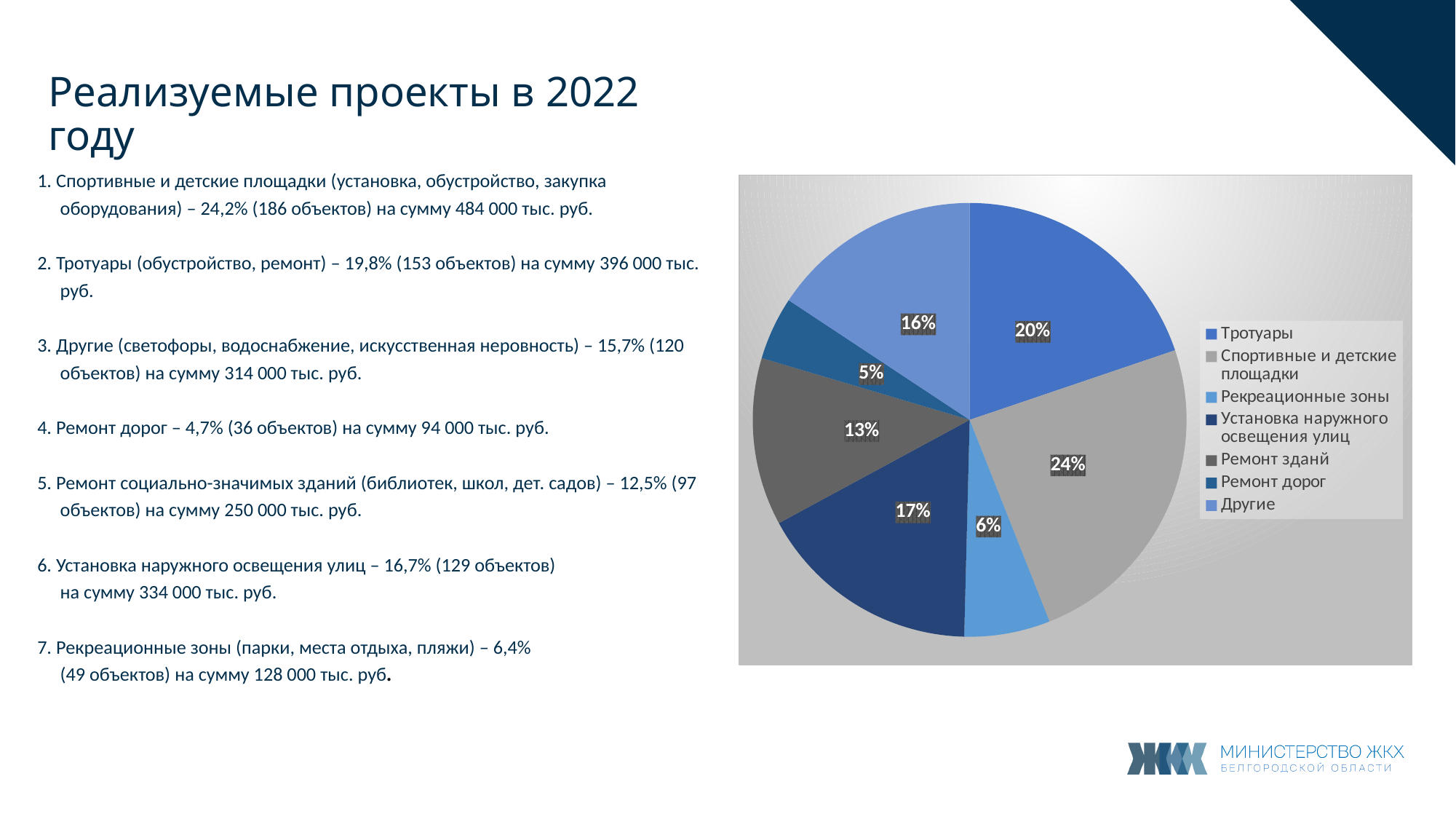
What percentage does the pie chart show for Спортивные и детские площадки? 24% How many slices does the pie chart have? 7 How many entries does the legend of the pie chart list? 7 What percentage does the pie chart show for Установка наружного освещения улиц? 17% Which slice is larger in the pie chart: Другие or Ремонт зданий? Другие What percentage does the pie chart show for Ремонт дорог? 5% Which category has the largest slice in the pie chart? Спортивные и детские площадки Which category has the smallest slice in the pie chart? Ремонт дорог What percentage does the pie chart show for Рекреационные зоны? 6% What is the difference in percentage points between Спортивные и детские площадки and Ремонт зданий in the pie chart? 11 What percentage does the pie chart show for Тротуары? 20% What type of chart is shown on the slide? Pie chart